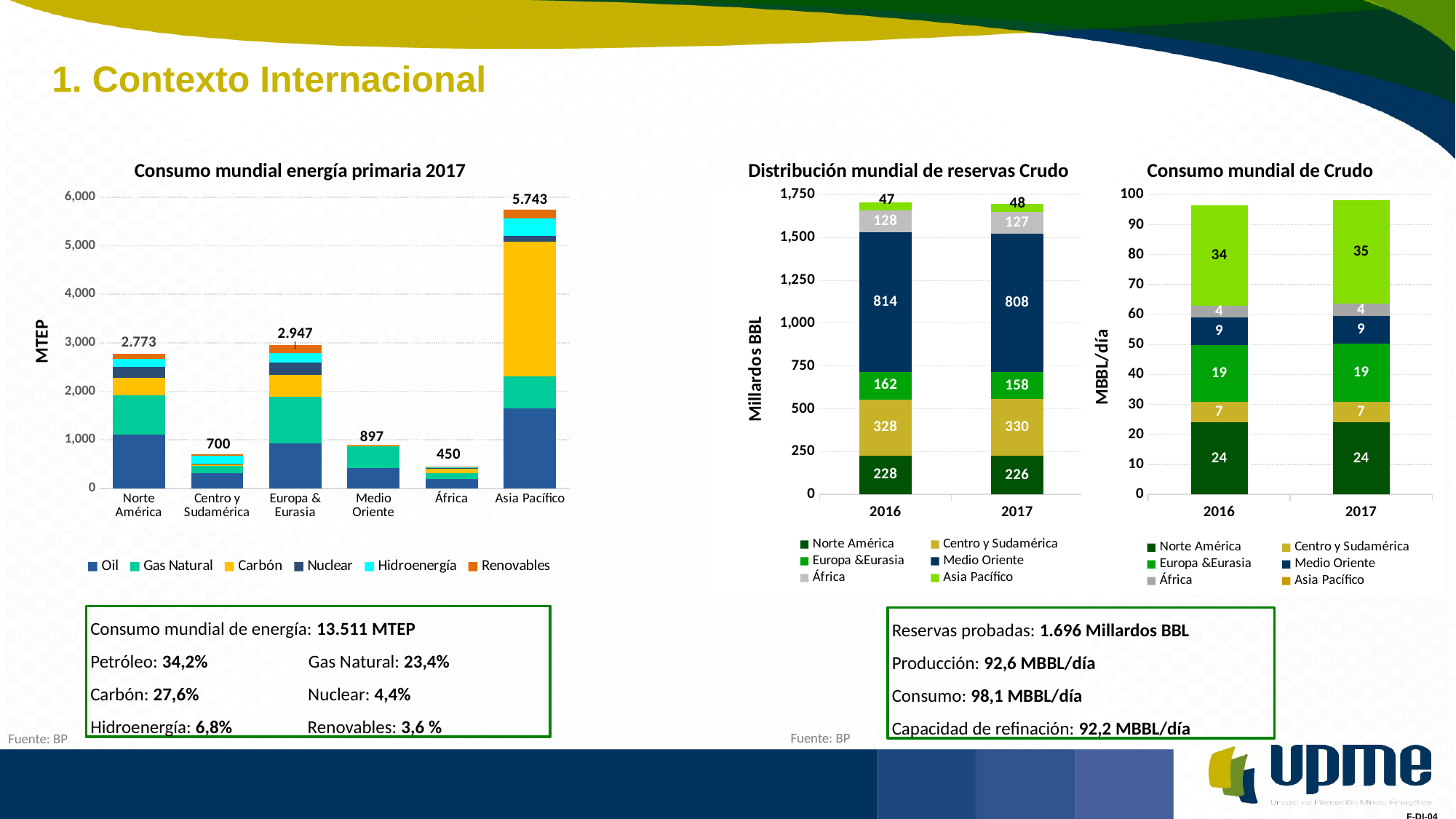
In the chart 'Distribución mundial de reservas Crudo', what is the value for Medio Oriente in 2017? 808 In the chart 'Consumo mundial de Crudo', does the Asia Pacífico value rise or fall from 2016 to 2017? Rises What kind of chart is 'Consumo mundial de Crudo'? Stacked bar chart In the chart 'Consumo mundial energía primaria 2017', which region has the lowest total consumption? África In the chart 'Consumo mundial de Crudo', what is the value for Asia Pacífico in 2017? 35 How many series does the legend of the chart 'Consumo mundial energía primaria 2017' list? 6 In the chart 'Consumo mundial energía primaria 2017', what is the difference between the totals for Europa & Eurasia and Norte América? 174 In the chart 'Consumo mundial energía primaria 2017', what is the total value labelled for Asia Pacífico? 5.743 How many regions are shown on the x axis of the chart 'Consumo mundial energía primaria 2017'? 6 In the chart 'Distribución mundial de reservas Crudo', is the Medio Oriente value larger in 2016 or in 2017? 2016 In the chart 'Distribución mundial de reservas Crudo', what is the value for Centro y Sudamérica in 2016? 328 In the chart 'Consumo mundial energía primaria 2017', which region has the highest total consumption? Asia Pacífico